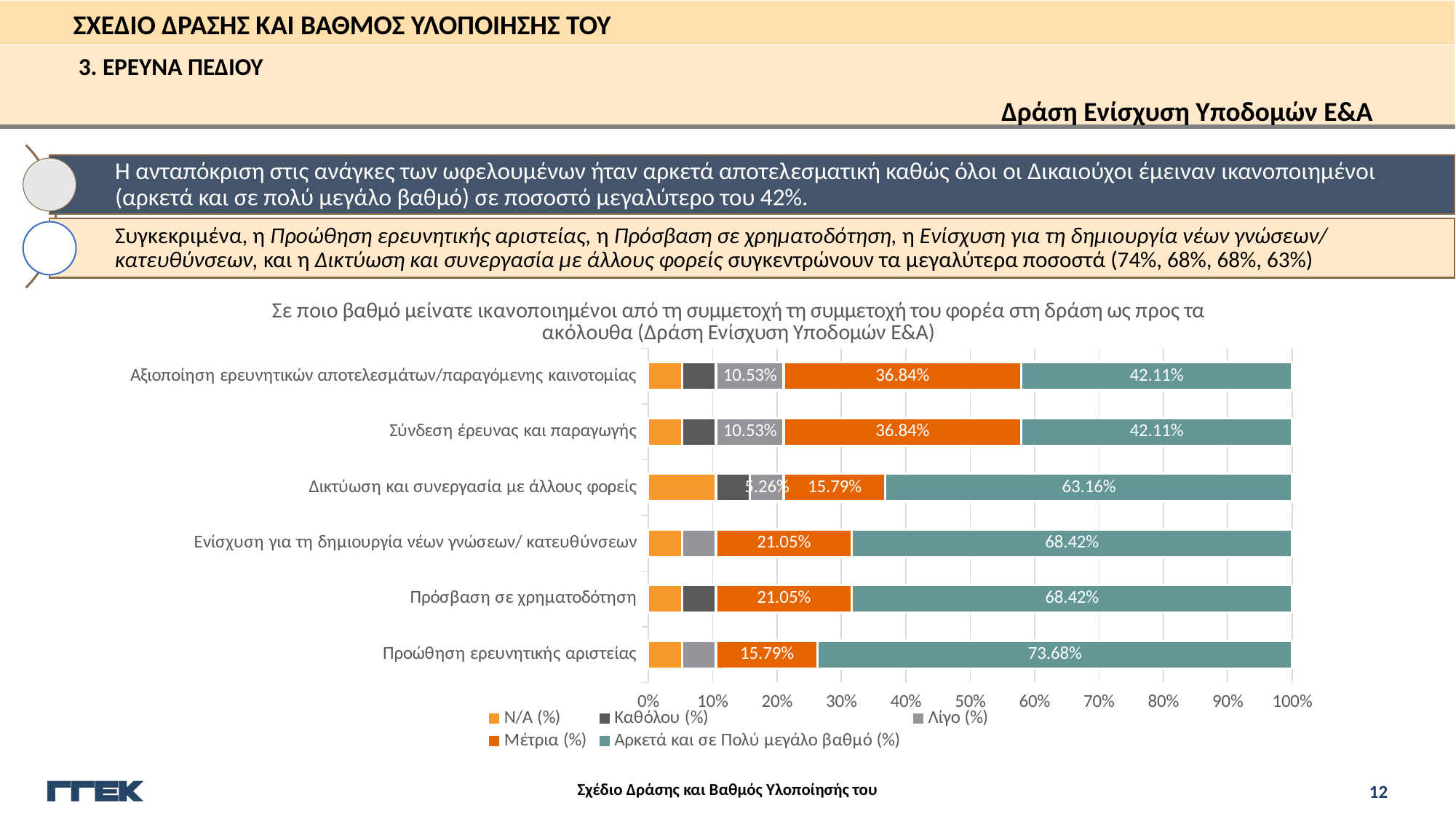
How many series does the chart legend list? 5 What is the value of 'Αρκετά και σε Πολύ μεγάλο βαθμό (%)' for 'Προώθηση ερευνητικής αριστείας'? 73.68% What is the difference between the 'Μέτρια (%)' values for 'Αξιοποίηση ερευνητικών αποτελεσμάτων/παραγόμενης καινοτομίας' and 'Πρόσβαση σε χρηματοδότηση'? 15.79% How many categories are plotted on the chart? 6 What is the value of 'Λίγο (%)' for 'Δικτύωση και συνεργασία με άλλους φορείς'? 5.26% What is the value of 'Μέτρια (%)' for 'Σύνδεση έρευνας και παραγωγής'? 36.84% Which colour represents the 'Μέτρια (%)' series in the chart? Orange Which category has the highest value for 'Αρκετά και σε Πολύ μεγάλο βαθμό (%)'? Προώθηση ερευνητικής αριστείας Which is larger: the 'Αρκετά και σε Πολύ μεγάλο βαθμό (%)' value for 'Ενίσχυση για τη δημιουργία νέων γνώσεων/ κατευθύνσεων' or for 'Σύνδεση έρευνας και παραγωγής'? Ενίσχυση για τη δημιουργία νέων γνώσεων/ κατευθύνσεων Is the 'N/A (%)' value for 'Αξιοποίηση ερευνητικών αποτελεσμάτων/παραγόμενης καινοτομίας' greater or less than 10%? less What type of chart is shown on the slide? Stacked bar chart What is the difference between the 'Αρκετά και σε Πολύ μεγάλο βαθμό (%)' values for 'Προώθηση ερευνητικής αριστείας' and 'Δικτύωση και συνεργασία με άλλους φορείς'? 10.52%